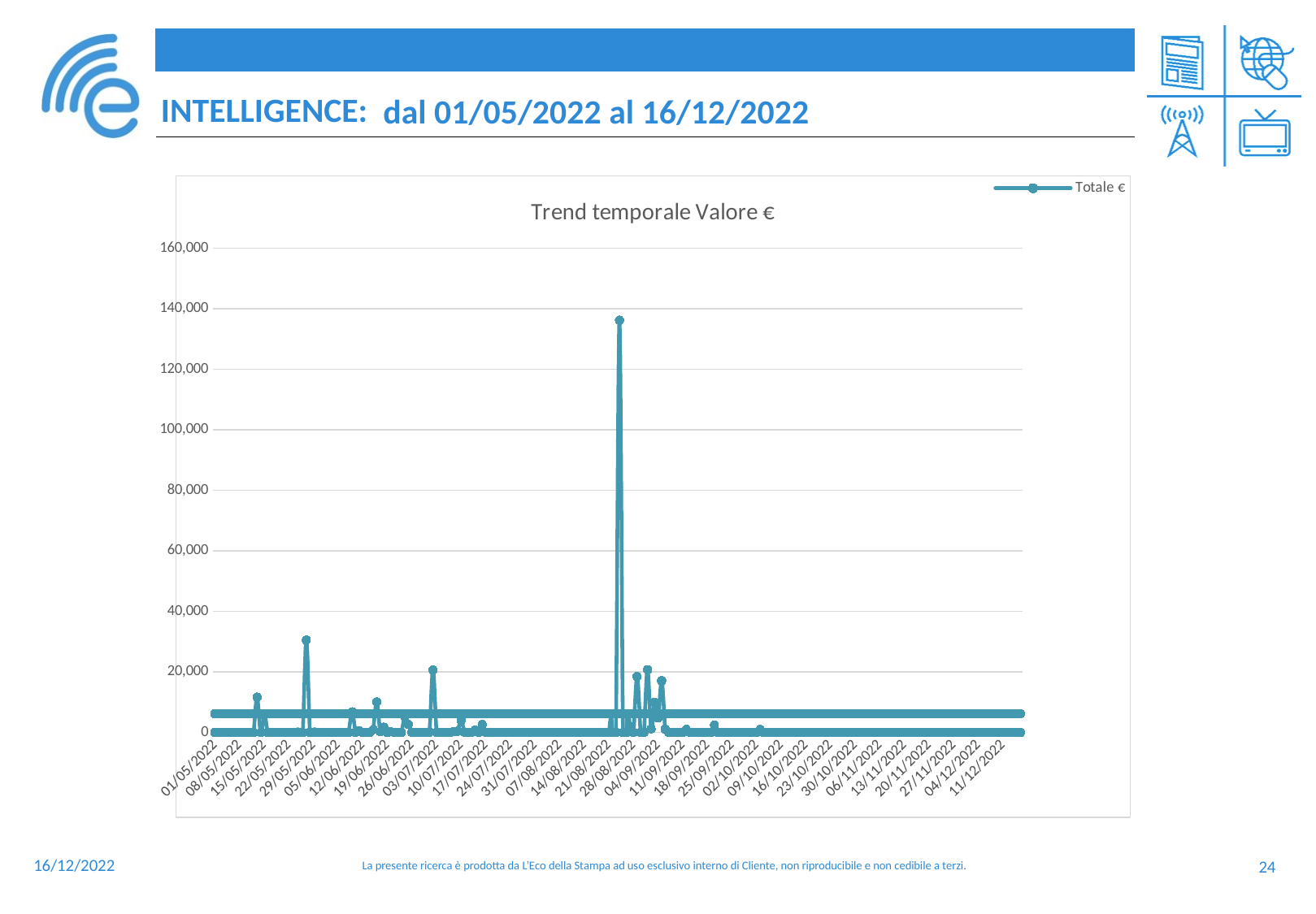
What kind of chart is shown on the slide? line chart Is the peak near 28/08/2022 larger than the peak near 29/05/2022? yes Is the peak near 29/05/2022 greater or less than 20,000? greater What is the name of the series shown in the legend? Totale € How many series does the legend list? 1 Is the highest peak of the line greater or less than 140,000? less Is the peak near 29/05/2022 greater or less than 40,000? less What is the title of the chart? Trend temporale Valore €